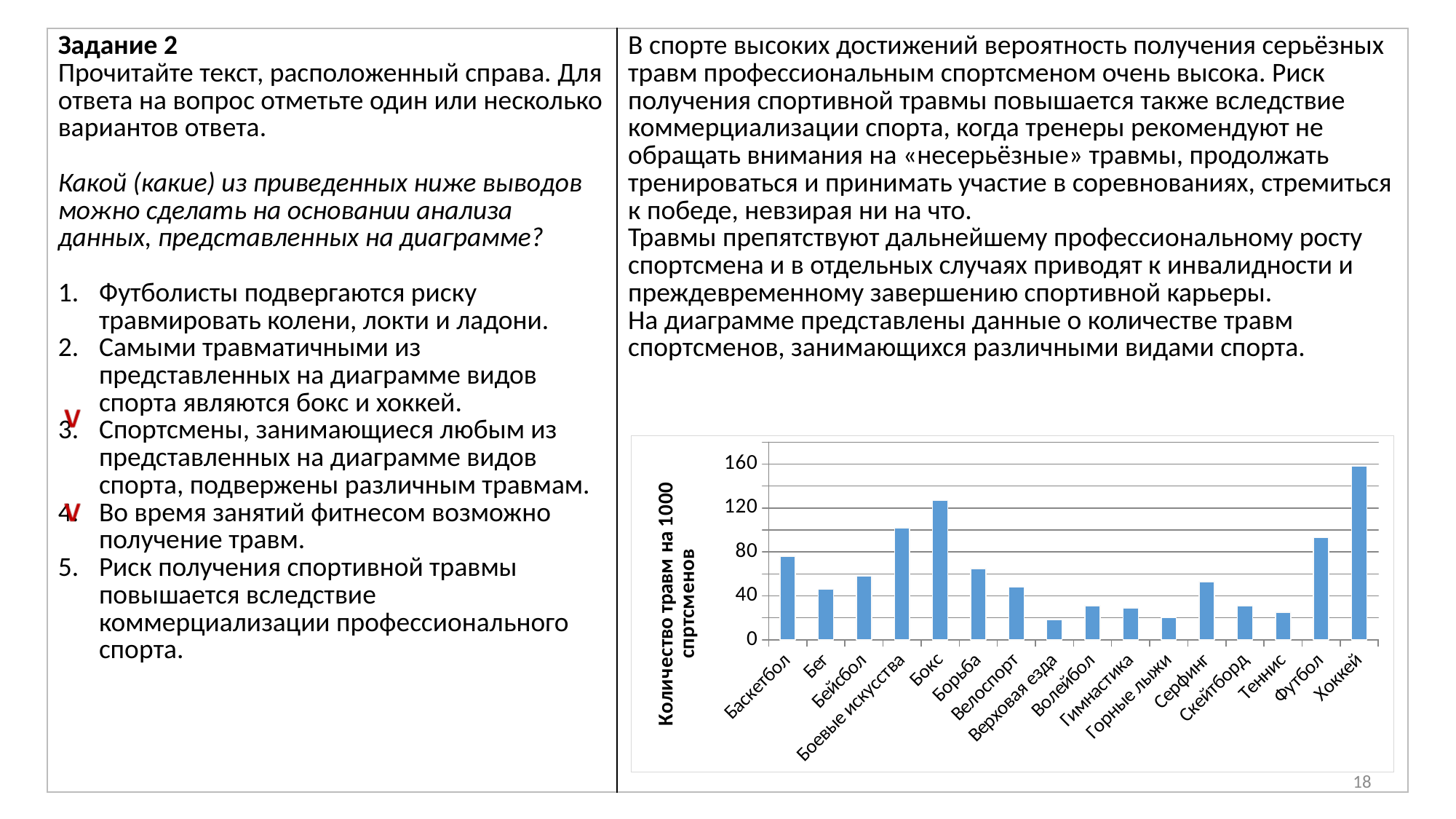
Is the value for Футбол greater or less than 80? greater What is the title of the vertical axis of the chart? Количество травм на 1000 спртсменов Is the value for Бокс greater or less than 120? greater Which has a lower value, Бег or Баскетбол? Бег Which has a higher value, Теннис or Серфинг? Серфинг Which sport has the highest number of injuries on the chart? Хоккей Is the value for Верховая езда greater or less than 40? less Which has a higher value, Бокс or Боевые искусства? Бокс What kind of chart is shown on the slide? bar chart How many sports (categories) are shown on the chart? 16